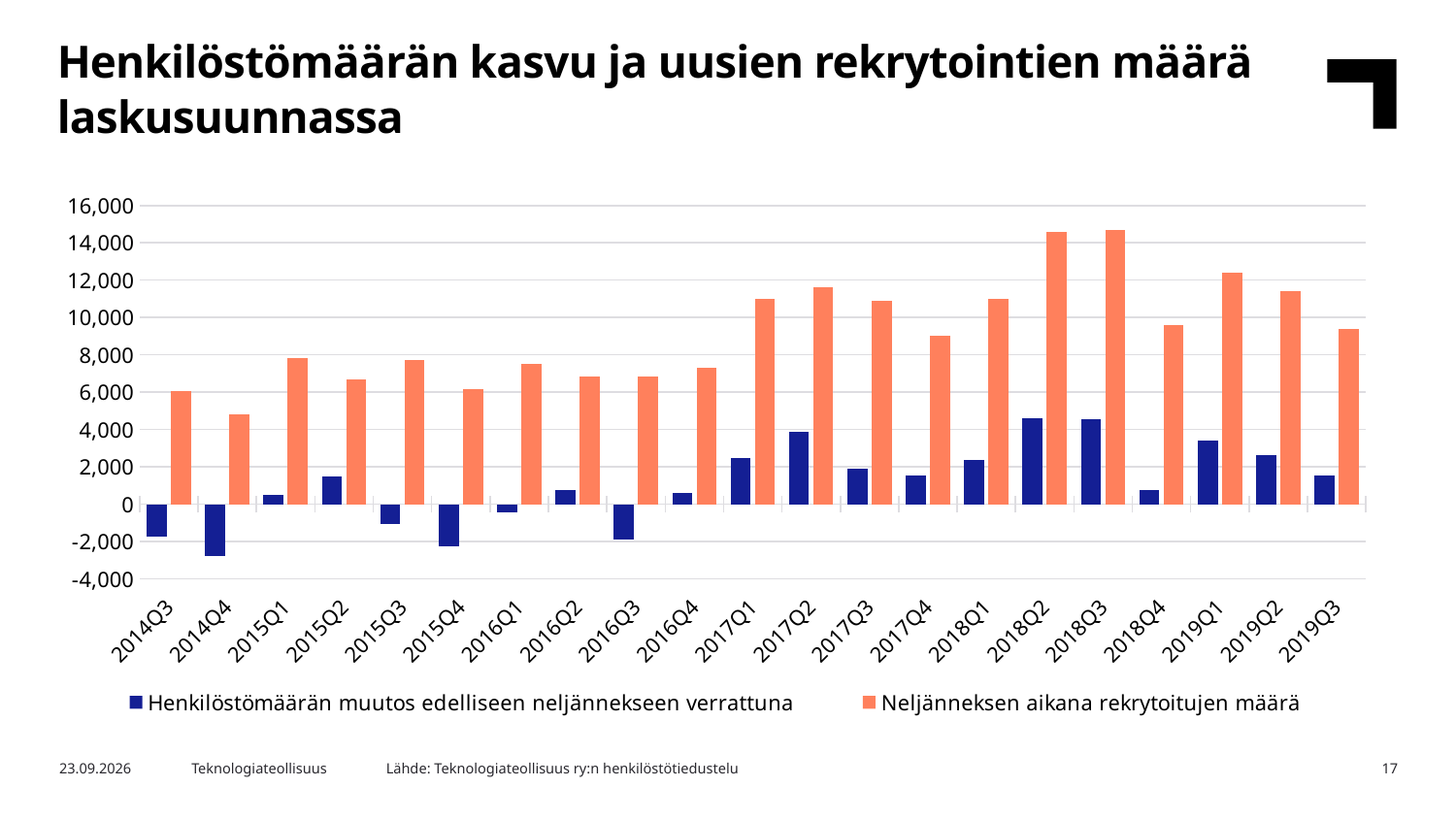
Is the value for 'Neljänneksen aikana rekrytoitujen määrä' in 2019Q3 greater or less than 10,000? less Which is larger for 'Neljänneksen aikana rekrytoitujen määrä': 2019Q1 or 2019Q2? 2019Q1 Which quarter has the lowest value for 'Henkilöstömäärän muutos edelliseen neljännekseen verrattuna'? 2014Q4 What kind of chart is shown on the slide? bar chart Is the value for 'Neljänneksen aikana rekrytoitujen määrä' in 2018Q2 greater or less than 14,000? greater How many quarters are shown on the x axis? 21 How many quarters show a negative value for 'Henkilöstömäärän muutos edelliseen neljännekseen verrattuna'? 6 Which quarter has the lowest value for 'Neljänneksen aikana rekrytoitujen määrä'? 2014Q4 Is the value for 'Neljänneksen aikana rekrytoitujen määrä' in 2017Q1 greater or less than 10,000? greater How many series does the legend list? 2 What colour represents 'Neljänneksen aikana rekrytoitujen määrä' in the legend? orange